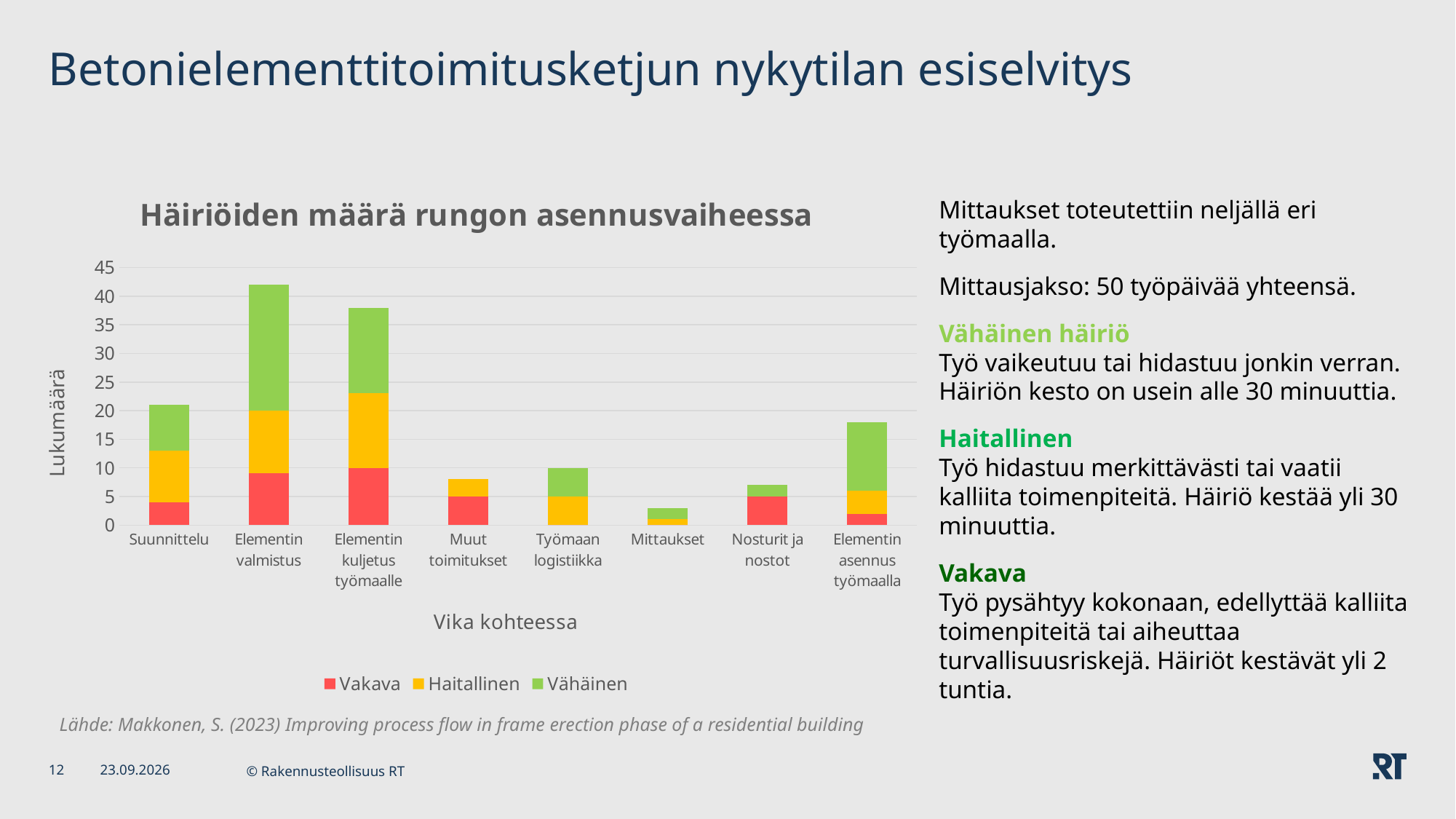
What is the total value of the bar for Työmaan logistiikka? 10 What is the title of the chart? Häiriöiden määrä rungon asennusvaiheessa How many series does the legend of the chart list? 3 How many categories are shown on the x axis of the chart? 8 Which category has the highest total number of disturbances (Lukumäärä)? Elementin valmistus Which category has the lowest total number of disturbances? Mittaukset Is the total value for Elementin asennus työmaalla greater or less than 20? less What kind of chart is shown on the slide? stacked bar chart Is the total value for Elementin valmistus greater or less than 40? greater Which is larger, the total for Elementin kuljetus työmaalle or the total for Elementin asennus työmaalla? Elementin kuljetus työmaalle Which colour represents the Vakava series in the chart? red